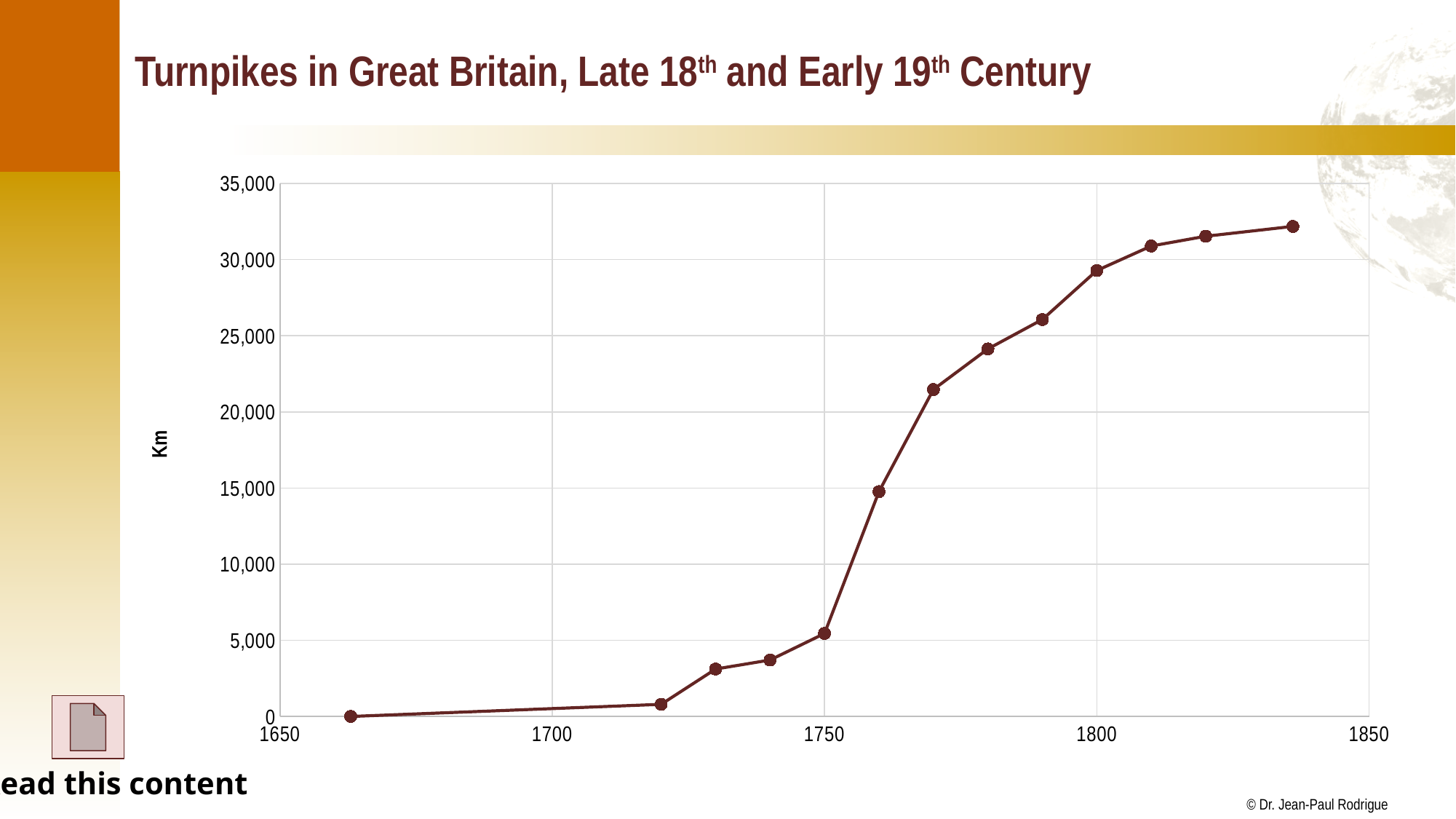
How many data points are plotted on the line? 13 What is the label on the vertical axis of the chart? Km Is the value for 1800 greater or less than 25,000? greater What kind of chart is shown on the slide? Line chart Do the values rise or fall as the years increase along the x axis? Rise Which year has the larger value, 1750 or 1800? 1800 Is the value for 1750 greater or less than 10,000? less Is the value for 1770 greater or less than 20,000? greater What is the title of the chart on the slide? Turnpikes in Great Britain, Late 18th and Early 19th Century What is the highest value shown on the vertical axis? 35,000